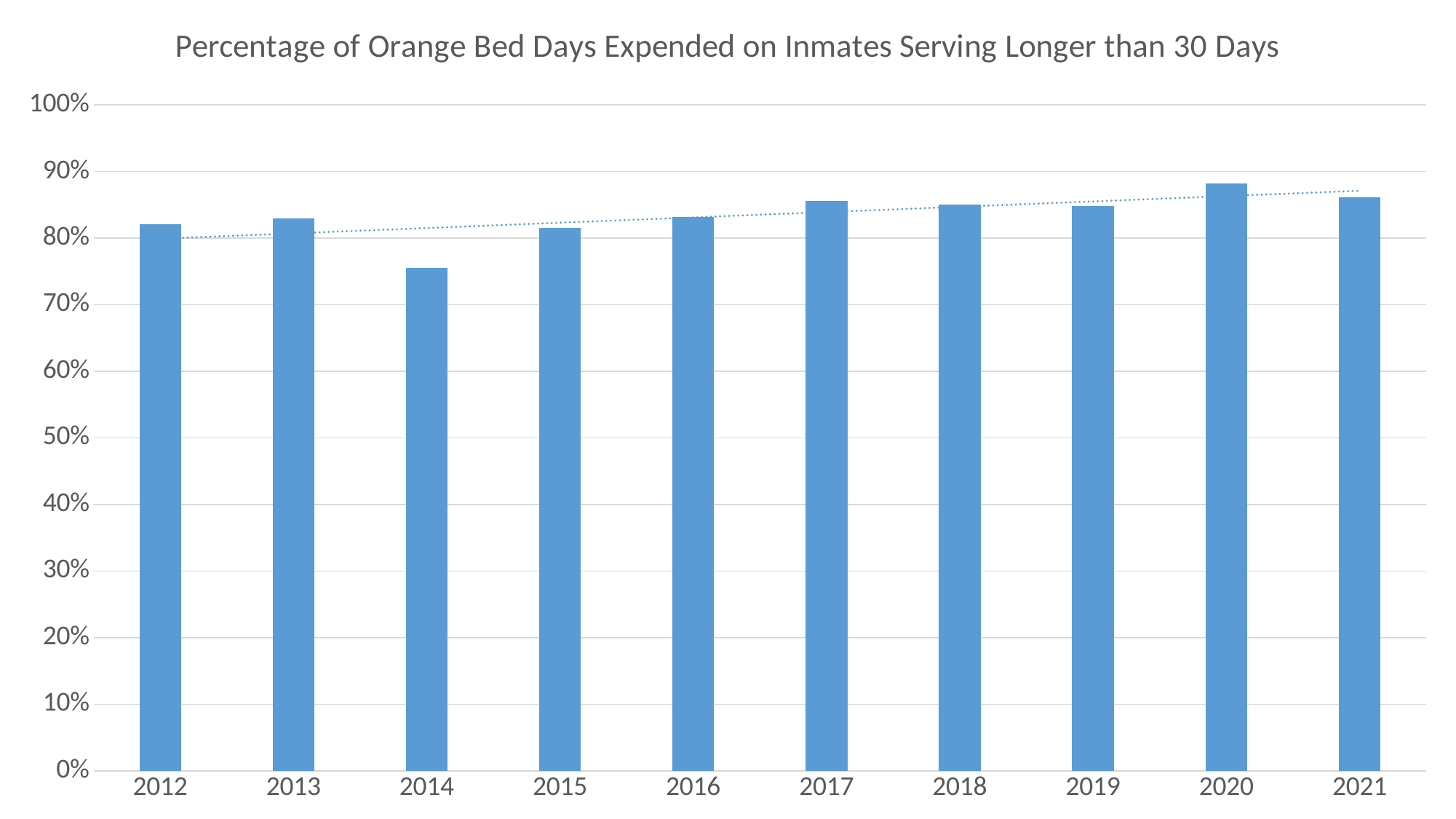
Which year has the larger value, 2012 or 2014? 2012 Which year has the highest percentage of Orange bed days expended on inmates serving longer than 30 days? 2020 What kind of chart is shown on the slide? Bar chart What is the title of the chart? Percentage of Orange Bed Days Expended on Inmates Serving Longer than 30 Days Is the value for 2014 greater or less than 80%? less Is the value for 2014 greater or less than 70%? greater Is the value for 2020 greater or less than 80%? greater How many years are shown on the x axis of the chart? 10 Which year has the lowest percentage of Orange bed days expended on inmates serving longer than 30 days? 2014 Which year has the larger value, 2014 or 2020? 2020 Does the dotted trend line across the bars rise or fall from 2012 to 2021? Rises